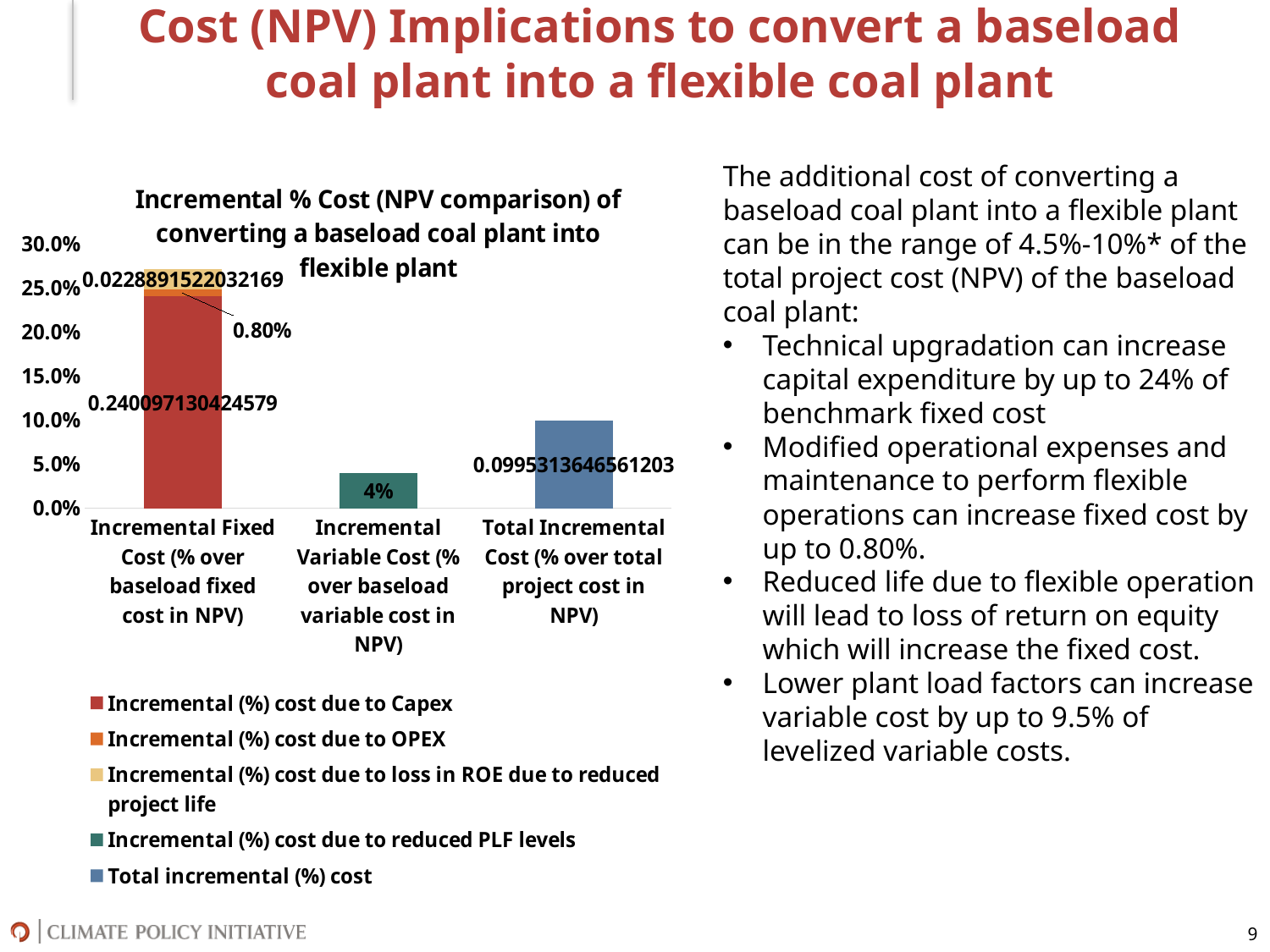
What is the data label for the Incremental (%) cost due to loss in ROE due to reduced project life segment? 0.022889522032169 What kind of chart is shown on the slide? Stacked bar chart How many series does the legend list? 5 What is the data label shown on the Incremental Variable Cost bar? 4% How many categories are shown on the x axis? 3 Which category has the tallest bar? Incremental Fixed Cost (% over baseload fixed cost in NPV) What colour represents Incremental (%) cost due to Capex in the legend? Red Is the bar for Total Incremental Cost greater or less than 5.0%? greater What is the data label for the Incremental (%) cost due to OPEX segment? 0.80% What is the data label shown for the Total Incremental Cost (% over total project cost in NPV) bar? 0.0995313646561203 What is the data label for the Incremental (%) cost due to Capex segment in the Incremental Fixed Cost bar? 0.240097130424579 Which category has the shortest bar? Incremental Variable Cost (% over baseload variable cost in NPV)